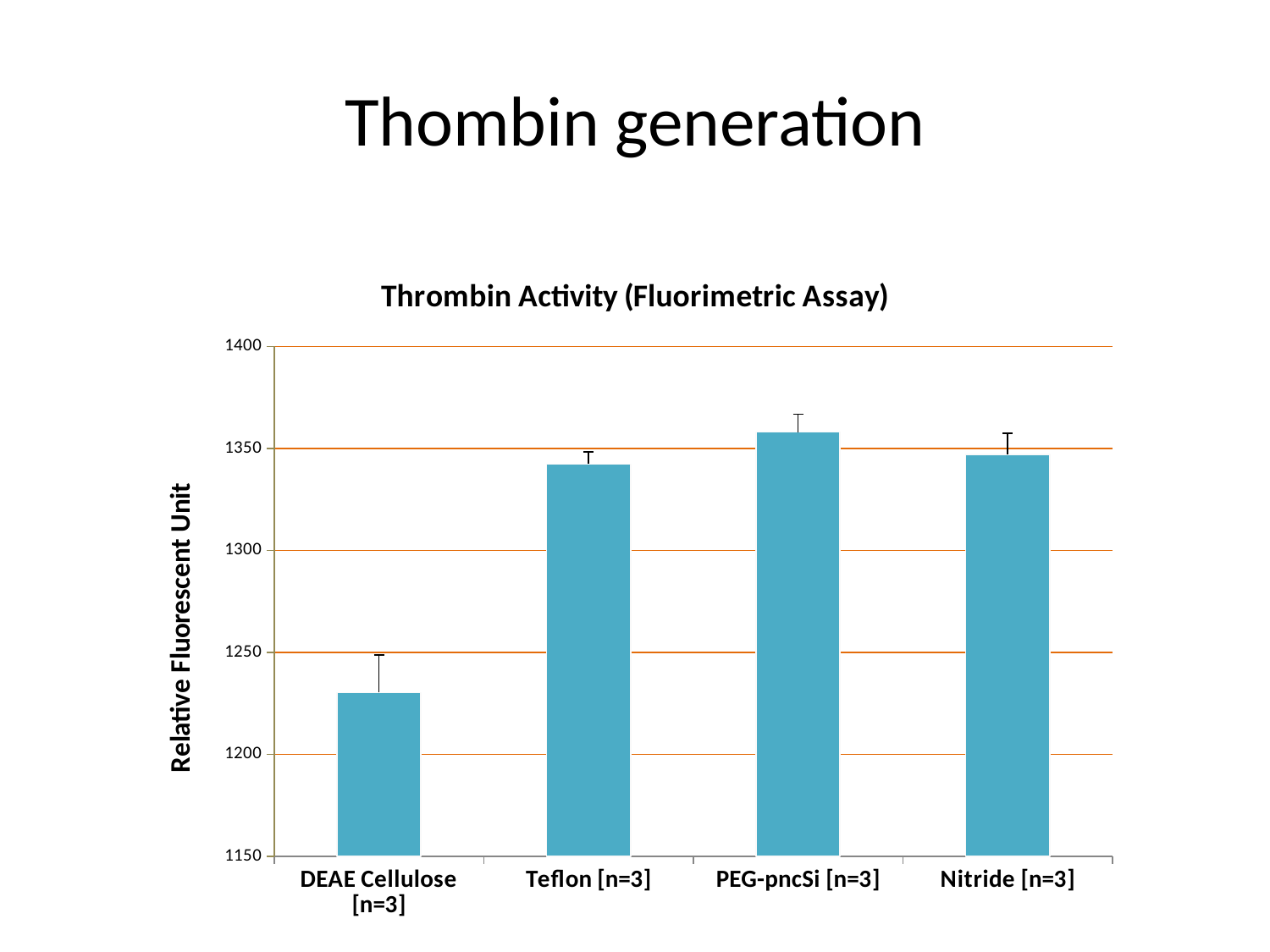
Which is larger, the value for PEG-pncSi [n=3] or the value for DEAE Cellulose [n=3]? PEG-pncSi [n=3] What is the title of the chart? Thrombin Activity (Fluorimetric Assay) What is the label on the vertical axis of the chart? Relative Fluorescent Unit What kind of chart is shown on the slide? bar chart Is the value for DEAE Cellulose [n=3] greater or less than 1250? less How many categories are plotted in the chart? 4 Is the value for Teflon [n=3] greater or less than 1300? greater Is the value for PEG-pncSi [n=3] greater or less than 1350? greater Which category has the highest value? PEG-pncSi [n=3] Which category has the lowest value? DEAE Cellulose [n=3] Which is larger, the value for Teflon [n=3] or the value for DEAE Cellulose [n=3]? Teflon [n=3]